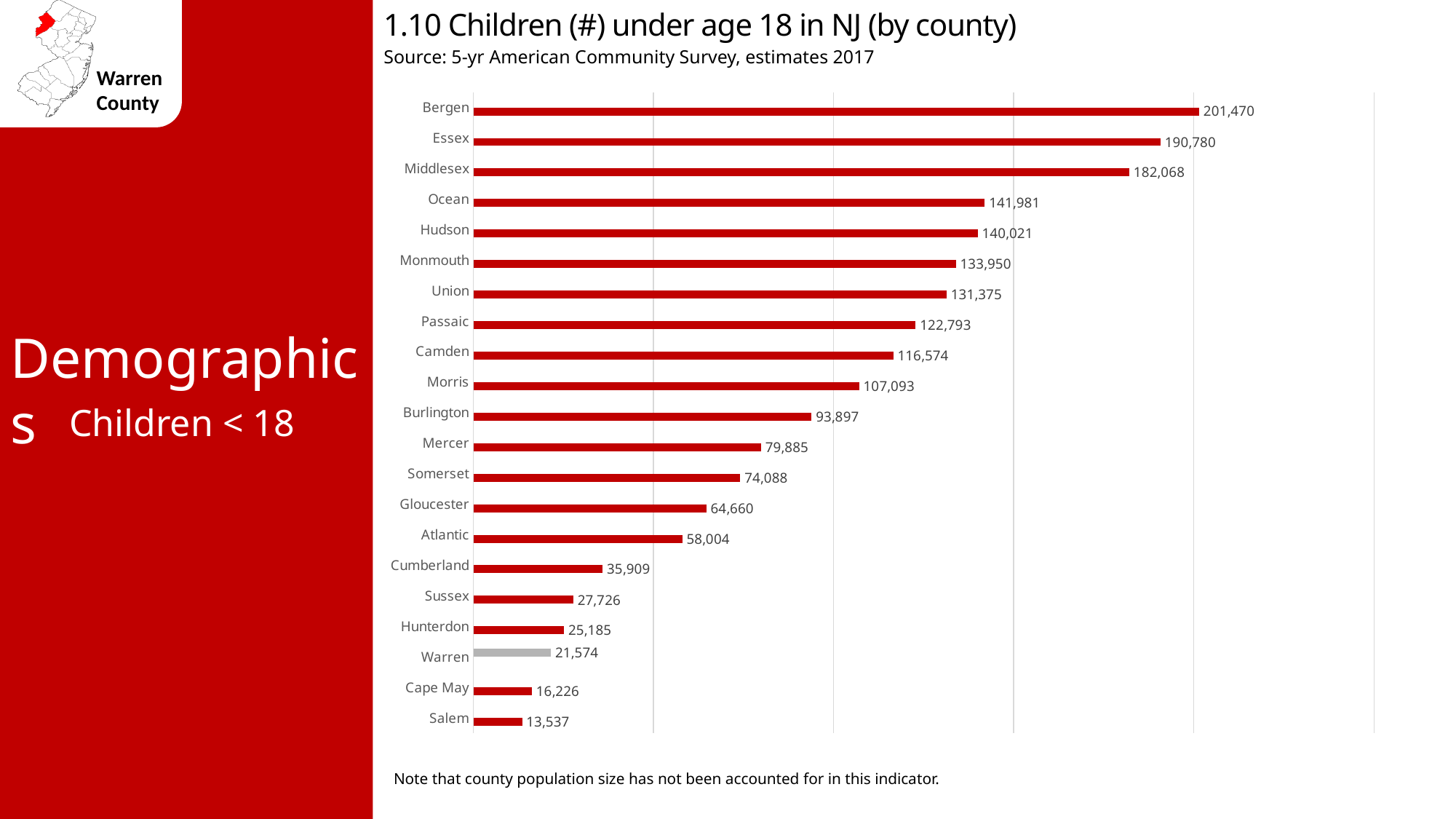
Which county's bar is shown in grey rather than red? Warren What is the difference between the values for Warren and Hunterdon? 3,611 What is the value shown for Bergen County? 201,470 Which has a larger value, Cape May or Sussex? Sussex What kind of chart is shown on the slide? Bar chart What is the value shown for Morris County? 107,093 How many counties are shown in the chart? 21 Which has a larger value, Ocean or Monmouth? Ocean What is the difference between the values for Bergen and Essex? 10,690 Which county has the lowest number of children under age 18? Salem Which county has the highest number of children under age 18? Bergen How many children under age 18 are there in Warren County? 21,574